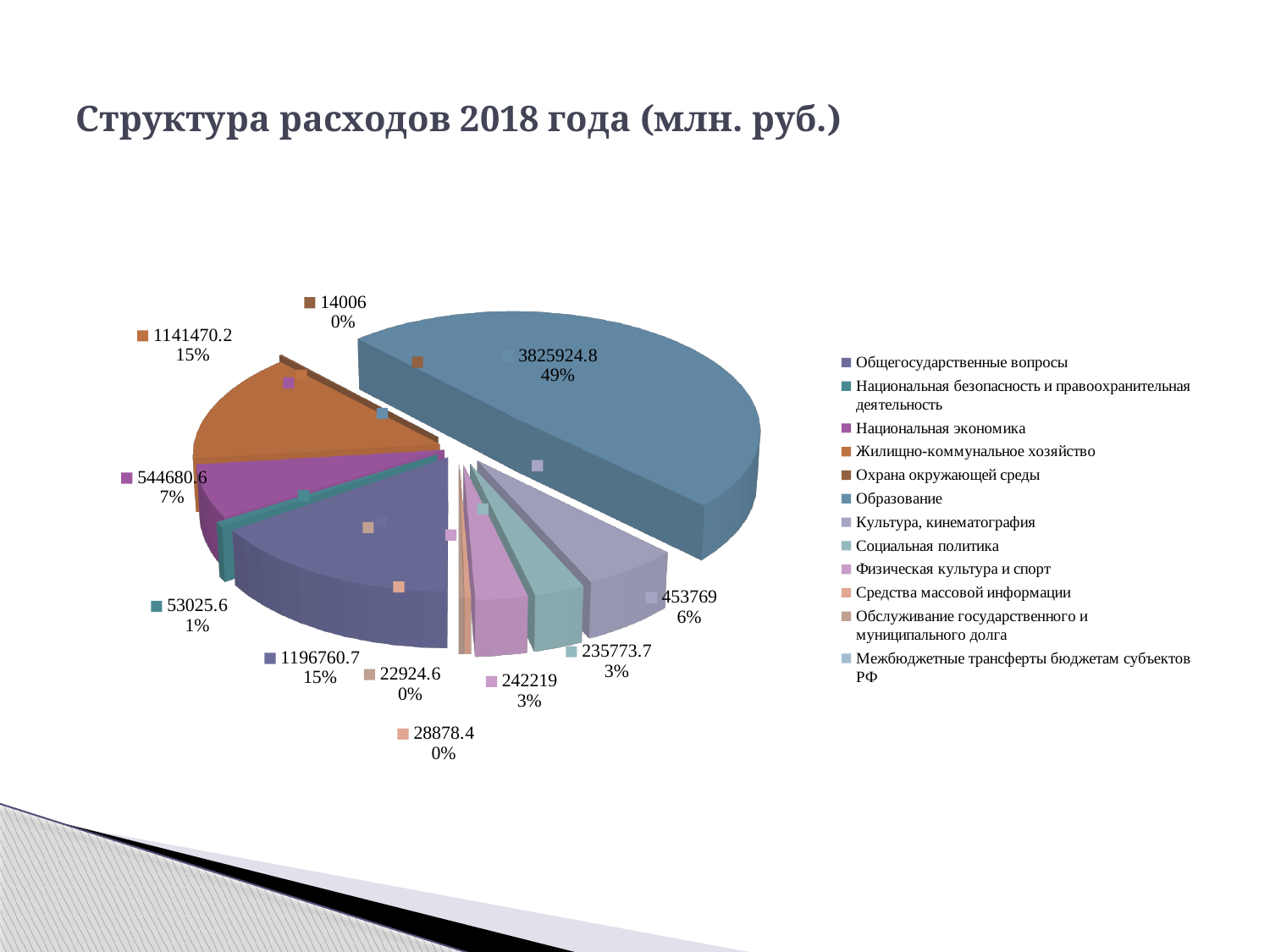
What is the difference between the values 1196760.7 and 1141470.2? 55290.5 What is the title of the chart? Структура расходов 2018 года (млн. руб.) What kind of chart is shown on the slide? pie chart How many entries does the legend list? 12 What share of the pie does the slice labelled 453769 represent? 6% What is the smallest value shown on the pie chart? 14006 What share of the pie does the largest slice (3825924.8) represent? 49% What share of the pie does the slice labelled 544680.6 represent? 7% What is the value of the slice for Жилищно-коммунальное хозяйство (orange)? 1141470.2 Which is larger: the slice labelled 242219 or the slice labelled 235773.7? 242219 What is the largest value shown on the pie chart? 3825924.8